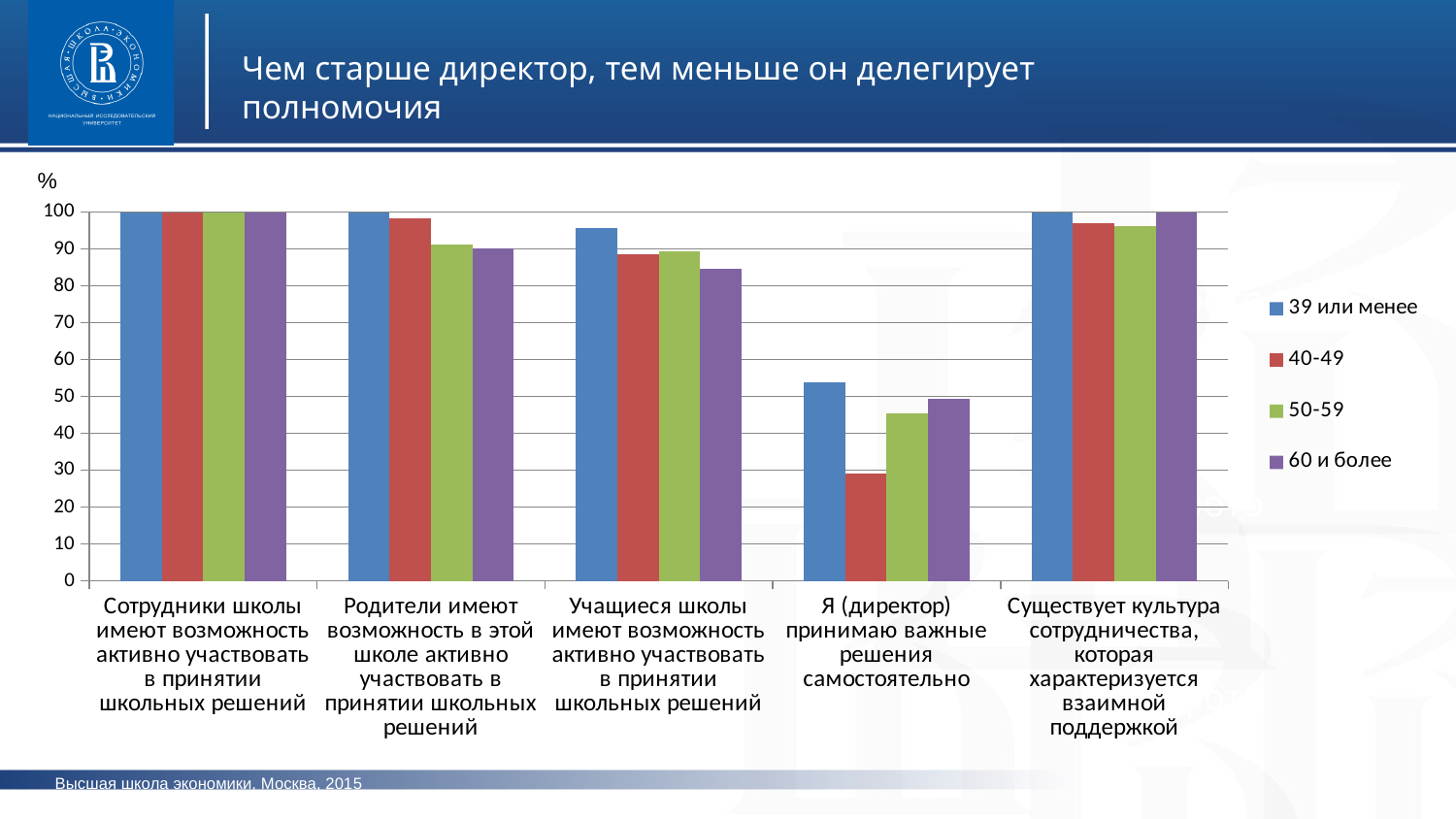
In the category "Родители имеют возможность в этой школе активно участвовать в принятии школьных решений", which is larger: the value for "40-49" or for "60 и более"? 40-49 What kind of chart is shown on the slide? bar chart How many series does the legend list? 4 Is the value for "40-49" in the category "Я (директор) принимаю важные решения самостоятельно" greater or less than 40? less What is the value for "39 или менее" in the category "Сотрудники школы имеют возможность активно участвовать в принятии школьных решений"? 100 In the category "Я (директор) принимаю важные решения самостоятельно", which series has the highest value? 39 или менее Which category has the lowest values overall? Я (директор) принимаю важные решения самостоятельно How many categories are shown along the x axis? 5 Is the value for "39 или менее" in the category "Я (директор) принимаю важные решения самостоятельно" greater or less than 50? greater What is the value for "60 и более" in the category "Существует культура сотрудничества, которая характеризуется взаимной поддержкой"? 100 In the category "Я (директор) принимаю важные решения самостоятельно", which series has the lowest value? 40-49 What unit is shown at the top of the y axis? %